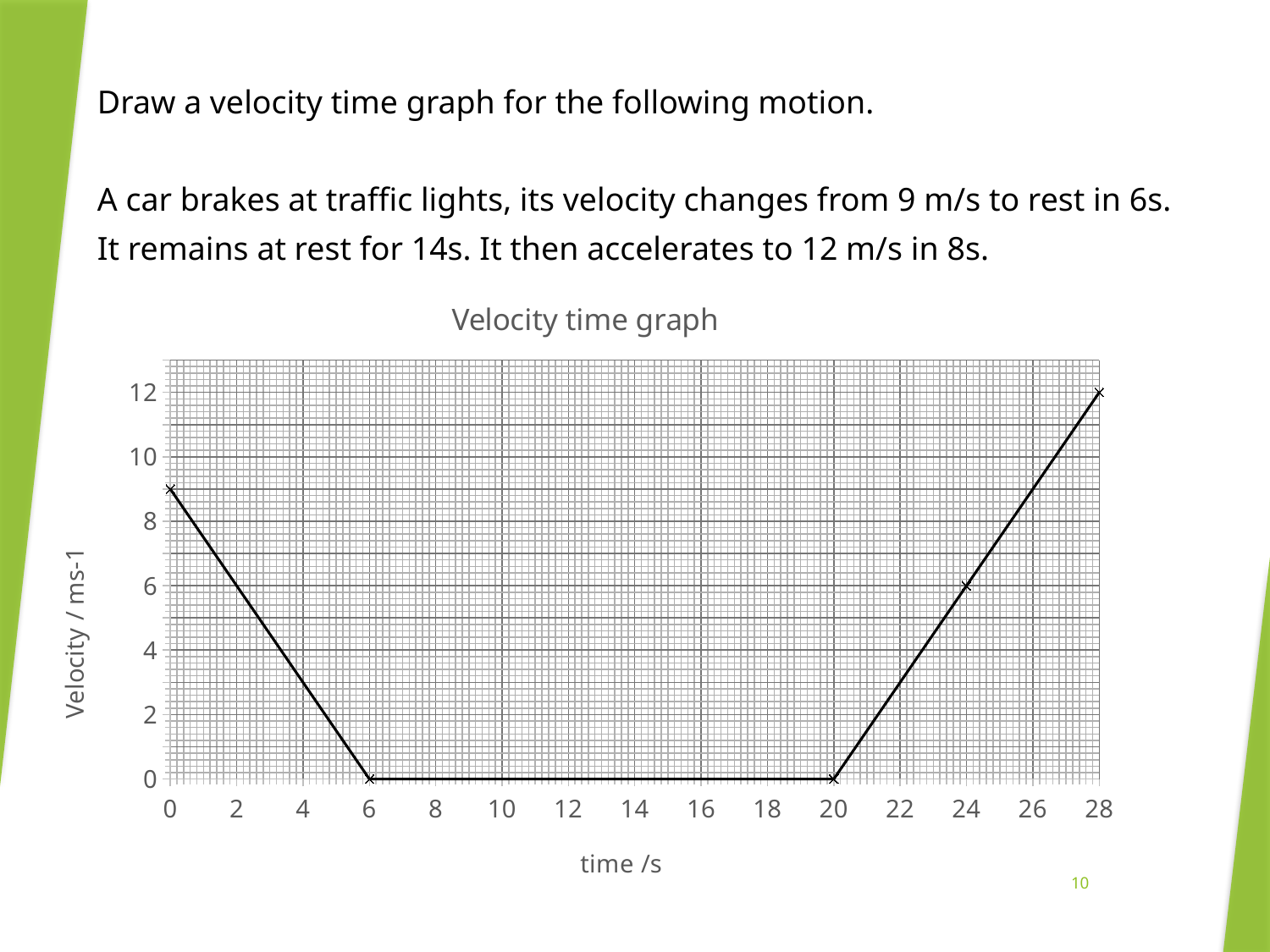
Which is larger, the velocity at 24 s or the velocity at 28 s? 28 s At which time is the velocity highest? 28 s Does the velocity rise or fall between 0 s and 6 s? fall What is the velocity at time 24 s? 6 What is the difference between the velocity at 28 s and the velocity at 24 s? 6 What is the title of the chart? Velocity time graph What is the velocity at time 6 s? 0 What kind of chart is shown on the slide? line chart What is the velocity at time 28 s? 12 Does the velocity rise or fall between 20 s and 28 s? rise Is the velocity at time 0 s greater or less than 8? greater How many marked data points are on the line? 5